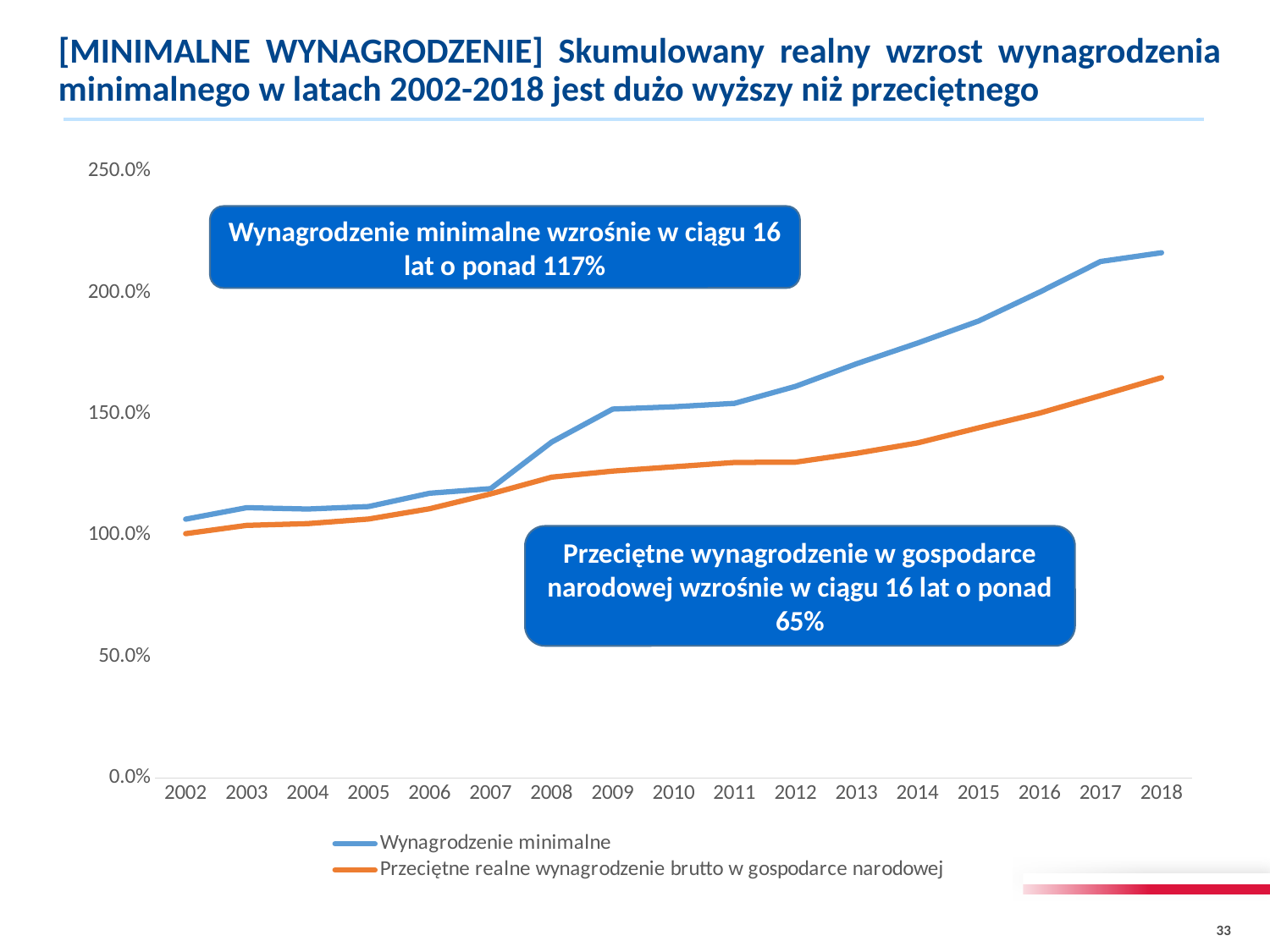
How many series does the legend list? 2 Which year has the highest value for Wynagrodzenie minimalne? 2018 What is the first series listed in the legend? Wynagrodzenie minimalne In 2018, which series has the higher value: Wynagrodzenie minimalne or Przeciętne realne wynagrodzenie brutto w gospodarce narodowej? Wynagrodzenie minimalne What kind of chart is shown on the slide? line chart Is the value for Przeciętne realne wynagrodzenie brutto w gospodarce narodowej in 2018 greater or less than 200.0%? less Is the value for Przeciętne realne wynagrodzenie brutto w gospodarce narodowej in 2018 greater or less than 150.0%? greater Is the value for Wynagrodzenie minimalne in 2018 greater or less than 200.0%? greater Do the values for Wynagrodzenie minimalne rise or fall from 2002 to 2018? rise How many years are shown on the x axis? 17